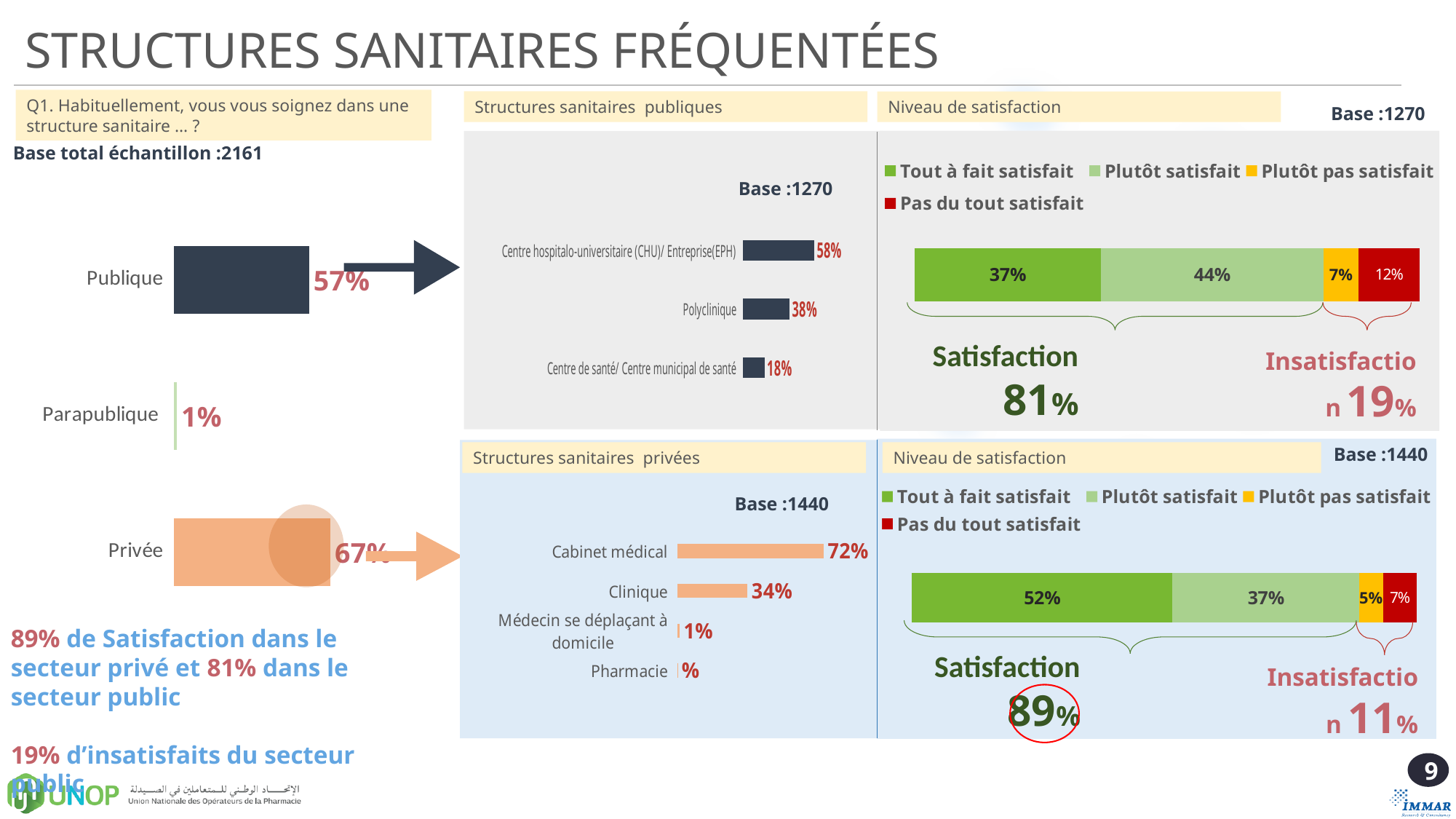
What type of chart is the 'Structures sanitaires privées' chart? Bar chart In the upper 'Niveau de satisfaction' stacked bar (public structures), what is the value for Plutôt satisfait? 44% In the 'Structures sanitaires privées' chart, what is the value for Cabinet médical? 72% In the 'Structures sanitaires privées' chart, which is larger, Clinique or Médecin se déplaçant à domicile? Clinique In the lower 'Niveau de satisfaction' stacked bar (private structures), what is the value for Pas du tout satisfait? 7% How many series does the legend of the upper 'Niveau de satisfaction' chart list? 4 In the 'Structures sanitaires publiques' chart, how many categories are shown? 3 In the left-hand bar chart (Q1), what is the value for Publique? 57% In the left-hand bar chart (Q1), which category has the lowest value? Parapublique In the left-hand bar chart (Q1), which category has the highest value? Privée In the 'Structures sanitaires publiques' chart, what is the value for Polyclinique? 38% In the 'Structures sanitaires publiques' chart, what is the difference between the CHU/EPH value and the Centre de santé value? 40%